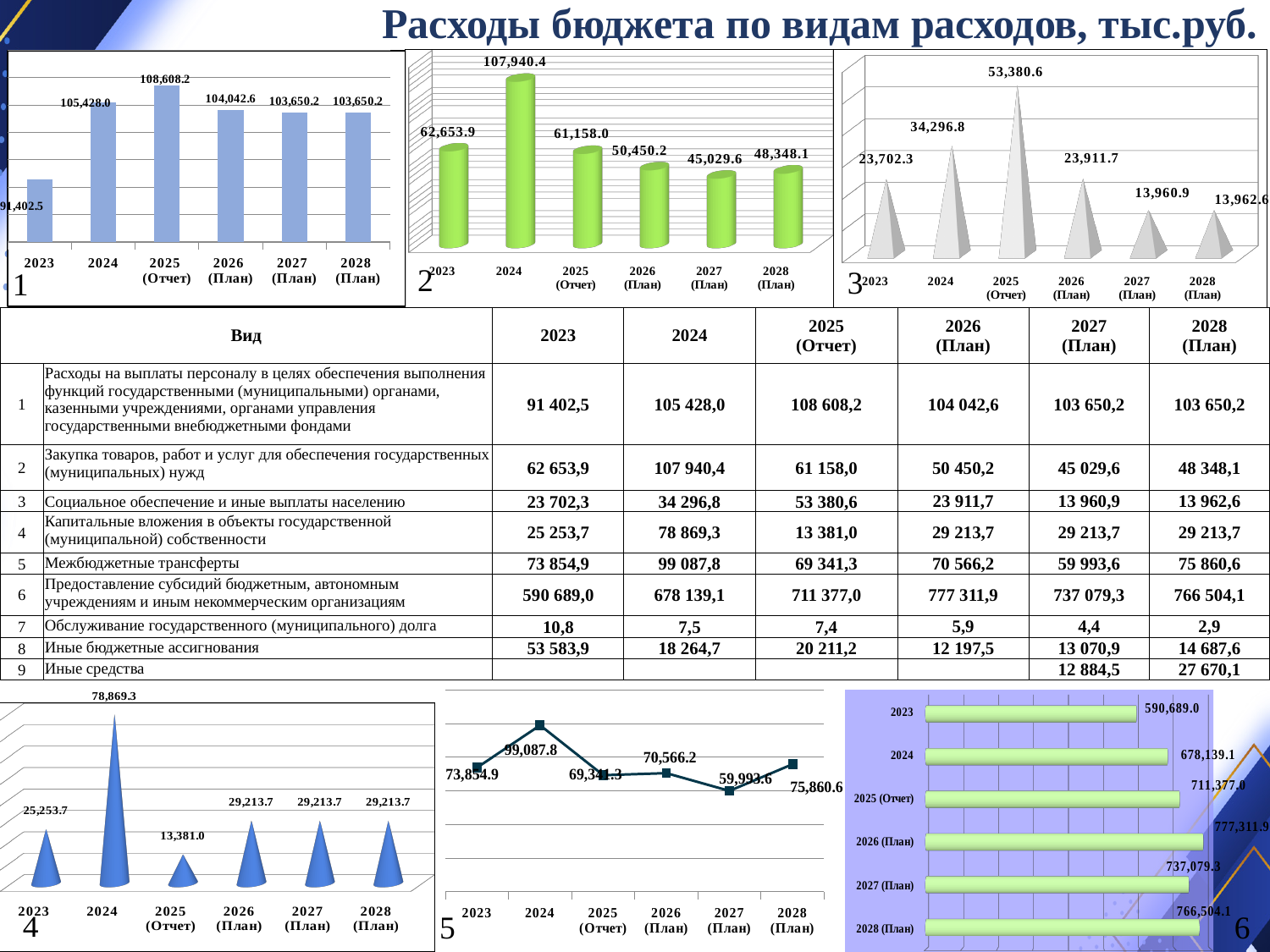
In chart 3 (top right), which year has the highest value? 2025 (Отчет) In chart 4 (bottom left), what is the value for 2024? 78,869.3 In chart 1 (top left), which year has the lowest value? 2023 In chart 2 (top middle), what is the difference between the 2024 value and the 2025 (Отчет) value? 46,782.4 In chart 6 (bottom right), which year has the highest value? 2026 (План) In chart 5 (bottom middle), what is the value for 2027 (План)? 59,993.6 In chart 2 (top middle), which year has the highest value? 2024 In chart 1 (top left), what is the value for 2025 (Отчет)? 108,608.2 In chart 3 (top right), what is the value for 2027 (План)? 13,960.9 In chart 4 (bottom left), which is larger, the value for 2023 or the value for 2025 (Отчет)? 2023 What kind of chart is chart 5 (bottom middle)? Line chart How many years are shown on the x axis of chart 1 (top left)? 6